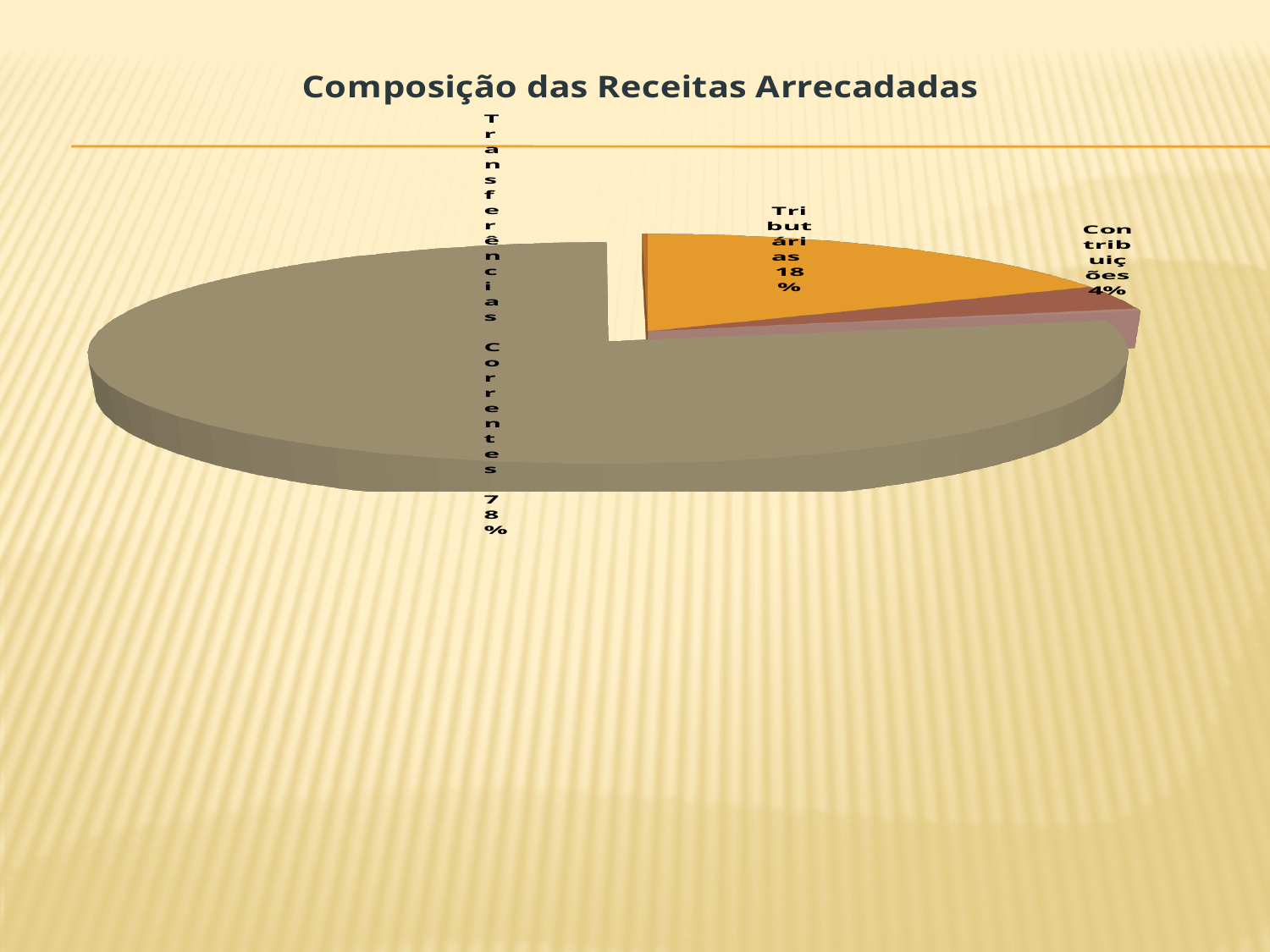
What share of the pie is Contribuições? 4% Which is larger, Tributárias or Contribuições? Tributárias What is the difference in percentage points between Tributárias and Contribuições? 14 What share of the pie is Tributárias? 18% What is the difference in percentage points between Transferências Correntes and Tributárias? 60 What share of the pie is Transferências Correntes? 78% What colour is the Tributárias slice? Orange What is the title of the chart? Composição das Receitas Arrecadadas What kind of chart is shown on the slide? Pie chart Which slice of the pie is the smallest? Contribuições Which slice of the pie is the largest? Transferências Correntes How many slices does the pie chart have? 3